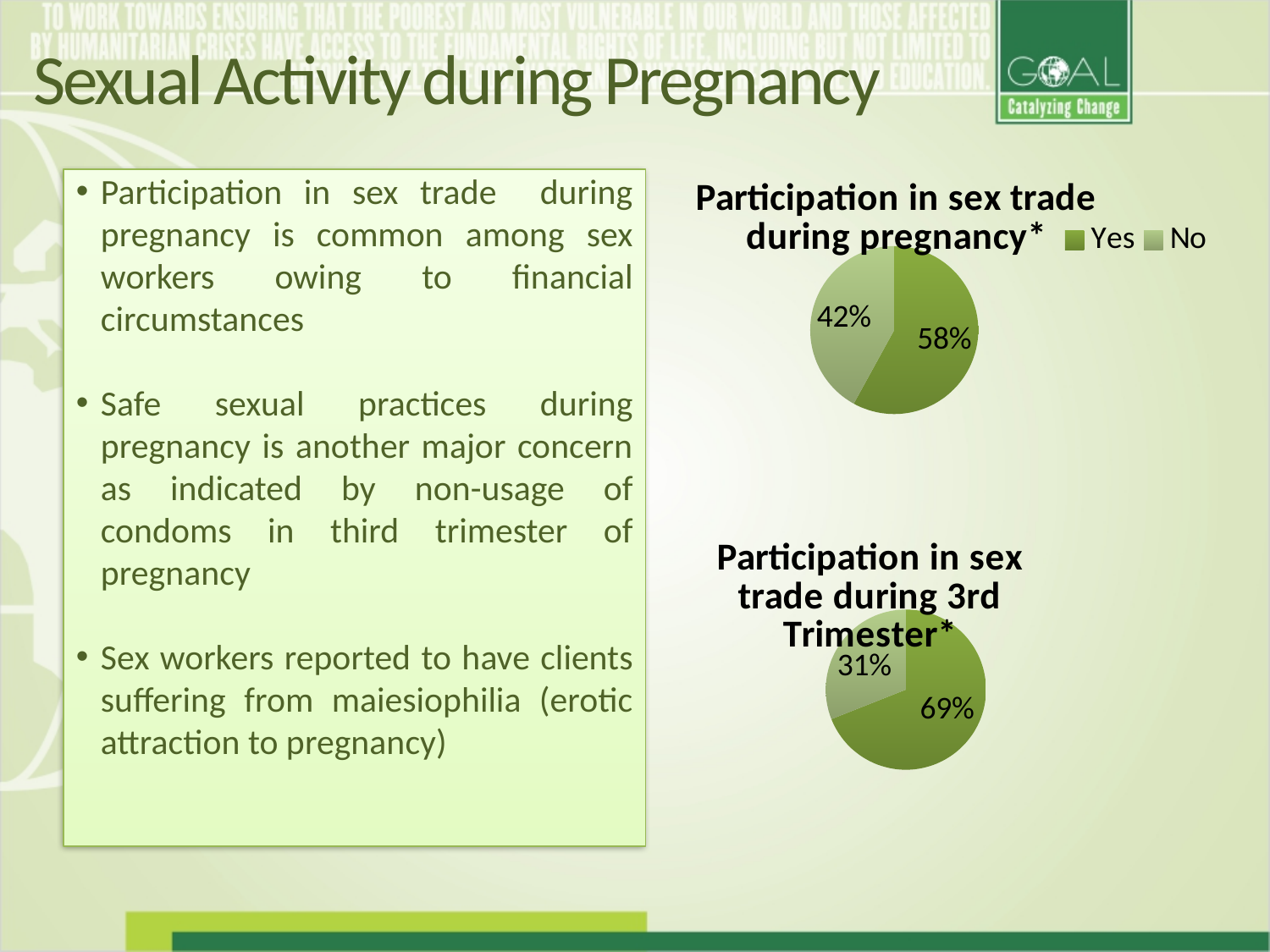
In the chart titled "Participation in sex trade during 3rd Trimester*", what is the smaller percentage shown? 31% In the chart titled "Participation in sex trade during pregnancy*", what is the difference in percentage points between Yes and No? 16 In the chart titled "Participation in sex trade during pregnancy*", how many entries does the legend list? 2 How many slices does the pie chart titled "Participation in sex trade during 3rd Trimester*" have? 2 In the chart titled "Participation in sex trade during 3rd Trimester*", what is the larger percentage shown? 69% Which chart shows the larger Yes share: "Participation in sex trade during pregnancy*" or "Participation in sex trade during 3rd Trimester*"? Participation in sex trade during 3rd Trimester* What type of chart is the one titled "Participation in sex trade during pregnancy*"? Pie chart How many pie charts are shown on the slide? 2 In the chart titled "Participation in sex trade during pregnancy*", what percentage is shown for No? 42% In the chart titled "Participation in sex trade during pregnancy*", which category has the larger share, Yes or No? Yes In the chart titled "Participation in sex trade during pregnancy*", what percentage is shown for Yes? 58% In the chart titled "Participation in sex trade during 3rd Trimester*", what is the difference in percentage points between the two slices? 38